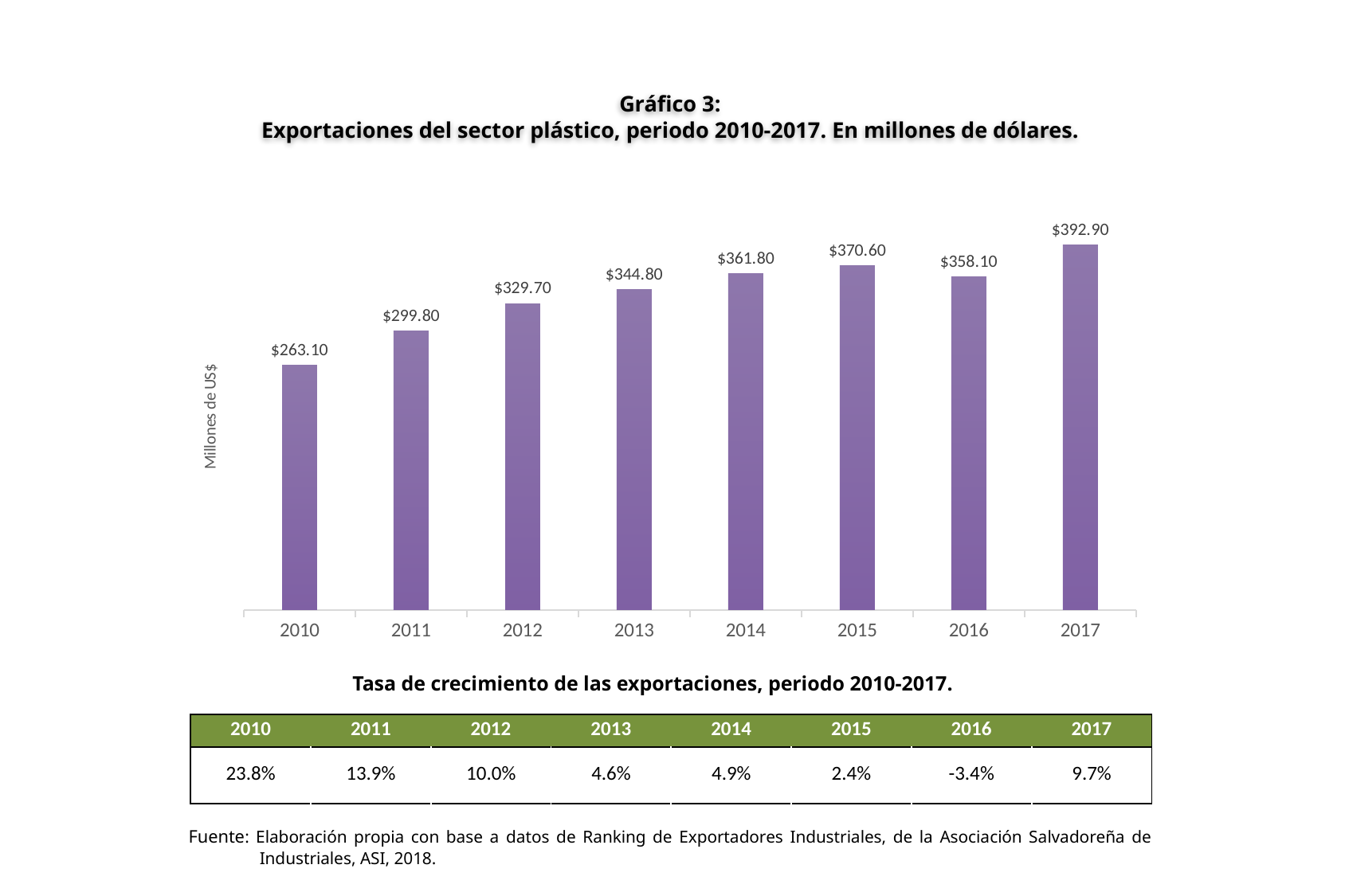
What is the export value for 2010? $263.10 What is the label on the vertical axis of the chart? Millones de US$ Which year has a larger export value, 2015 or 2016? 2015 Do the export values generally rise or fall from 2010 to 2017? Rise What is the export value for 2016? $358.10 What is the difference between the export values for 2017 and 2016? $34.80 Which year has the highest export value? 2017 What kind of chart is shown on the slide? Bar chart What is the export value for 2014? $361.80 Which year has the lowest export value? 2010 What is the difference between the export values for 2011 and 2010? $36.70 How many years are shown on the x axis of the chart? 8